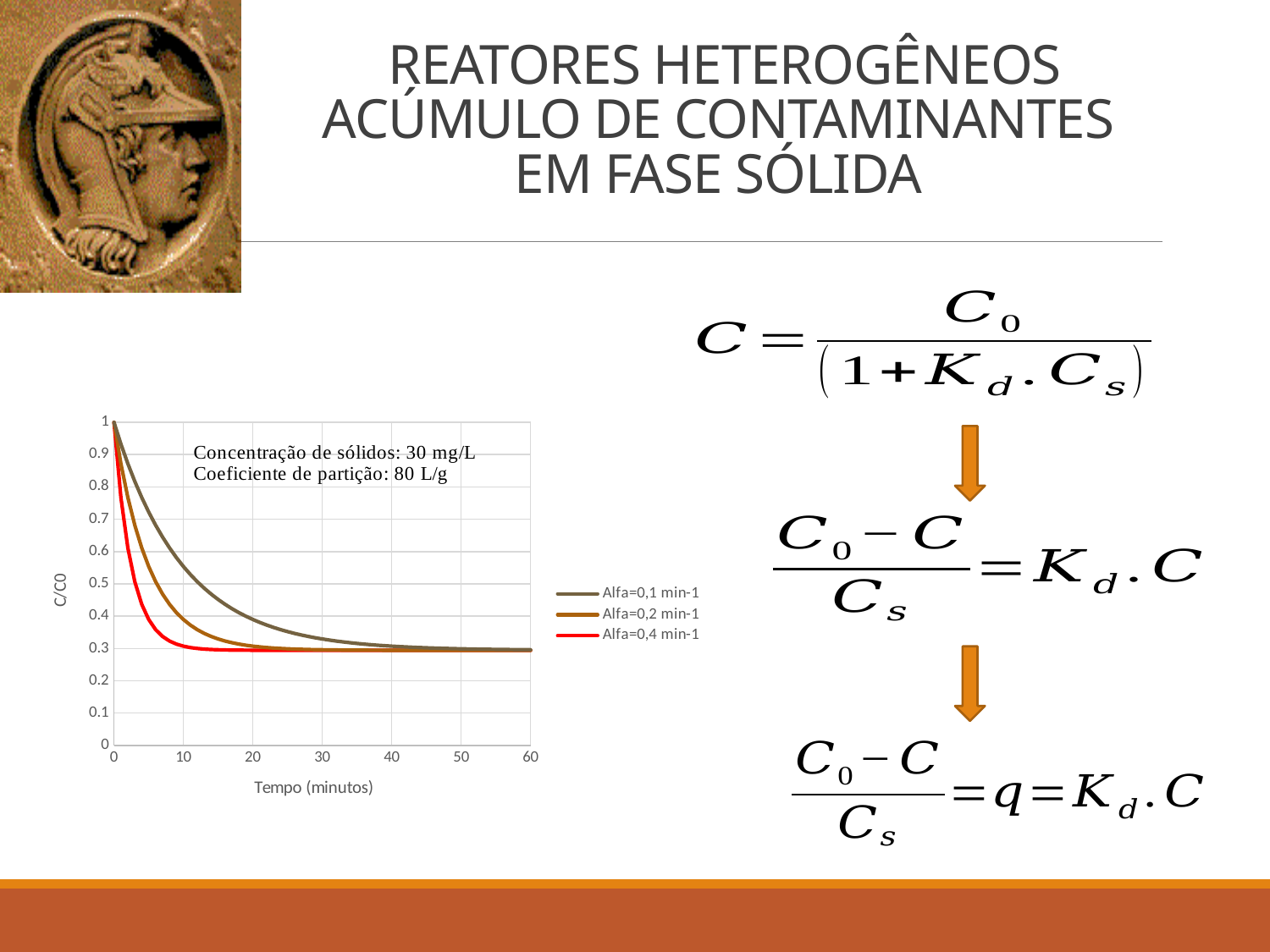
At 10 minutes, which series has the higher C/C0 value, Alfa=0,1 min-1 or Alfa=0,4 min-1? Alfa=0,1 min-1 Do the C/C0 values rise or fall as time increases along the x axis? fall At 5 minutes, is the C/C0 value for Alfa=0,2 min-1 greater or less than 0.5? greater What is the title of the x axis of the chart? Tempo (minutos) Which colour is used for the Alfa=0,4 min-1 series in the chart? red At 10 minutes, is the C/C0 value for Alfa=0,1 min-1 greater or less than 0.5? greater At 60 minutes, is the C/C0 value for Alfa=0,1 min-1 greater or less than 0.4? less Which series reaches the lowest C/C0 value soonest (decays fastest)? Alfa=0,4 min-1 What is the C/C0 value of all three series at time 0? 1 How many series does the chart legend list? 3 What kind of chart is shown on the slide? line chart